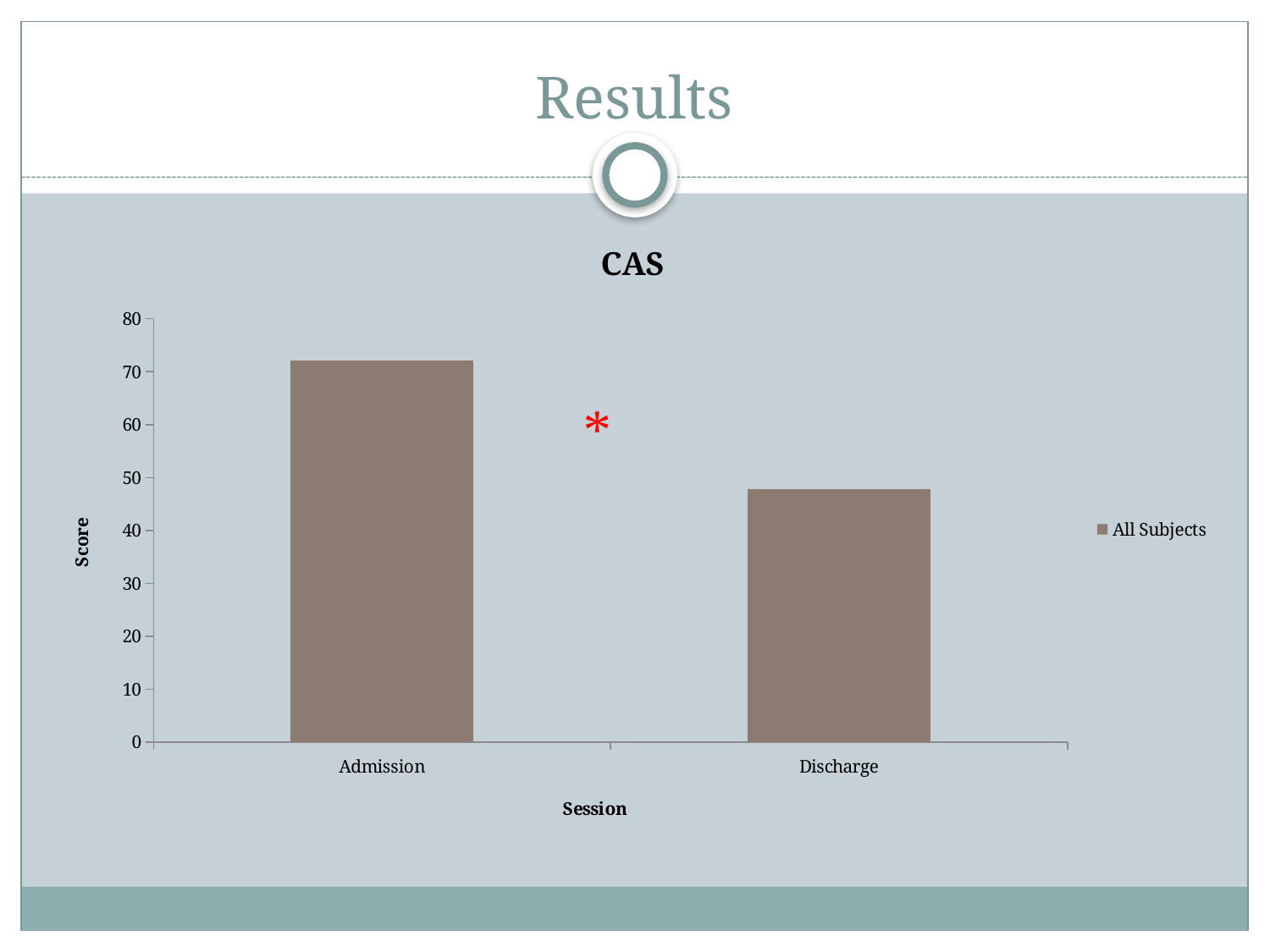
Is the score for Discharge greater or less than 40? greater What is the title of the chart? CAS Is the score for Admission greater or less than 70? greater How many categories are shown on the x axis? 2 What is the label of the y axis? Score What kind of chart is shown on the slide? bar chart Which session has the highest score? Admission Do the scores rise or fall from Admission to Discharge? fall How many series does the legend list? 1 Which is larger, the score at Admission or the score at Discharge? Admission Is the score for Discharge greater or less than 50? less Which session has the lowest score? Discharge